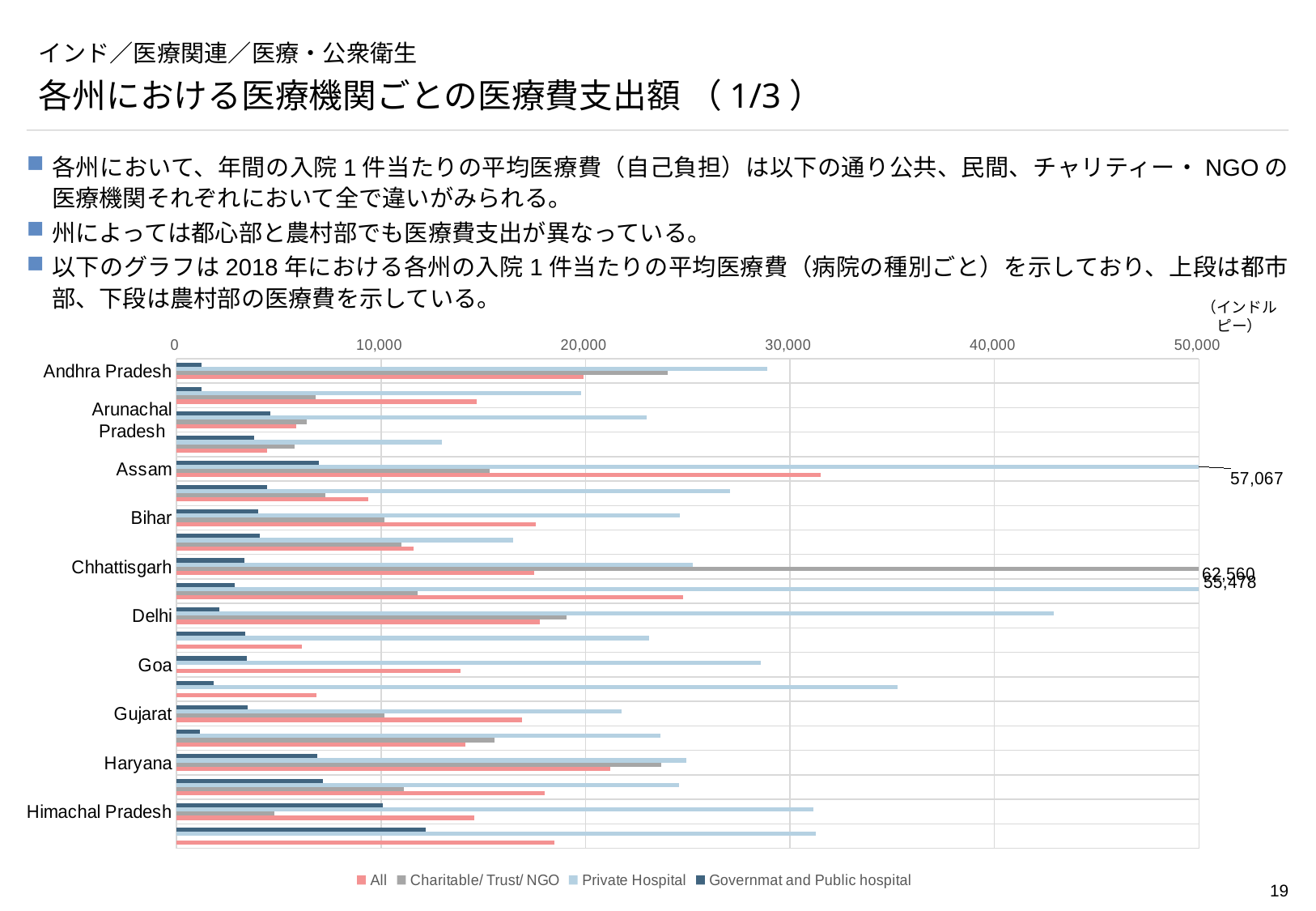
What is the labeled value of the Private Hospital bar in the lower (rural) group for Chhattisgarh? 62,560 What is the difference between the labeled values 62,560 and 55,478 for Chhattisgarh? 7,082 Is the Governmat and Public hospital value in the upper (urban) group for Andhra Pradesh greater or less than 10,000? less Is the Private Hospital value in the lower (rural) group for Delhi greater or less than 40,000? less What is the labeled value of the Charitable/ Trust/ NGO bar in the upper (urban) group for Chhattisgarh? 55,478 What is the highest value printed as a data label on the chart? 62,560 Which is larger: the urban Private Hospital value for Assam or the rural Private Hospital value for Chhattisgarh? Chhattisgarh (62,560) How many states are labeled on the vertical axis of the chart? 10 How many series does the legend list? 4 What is the labeled value of the Private Hospital bar in the upper (urban) group for Assam? 57,067 Which legend entry is shown in red/pink? All What kind of chart is shown on the slide? bar chart